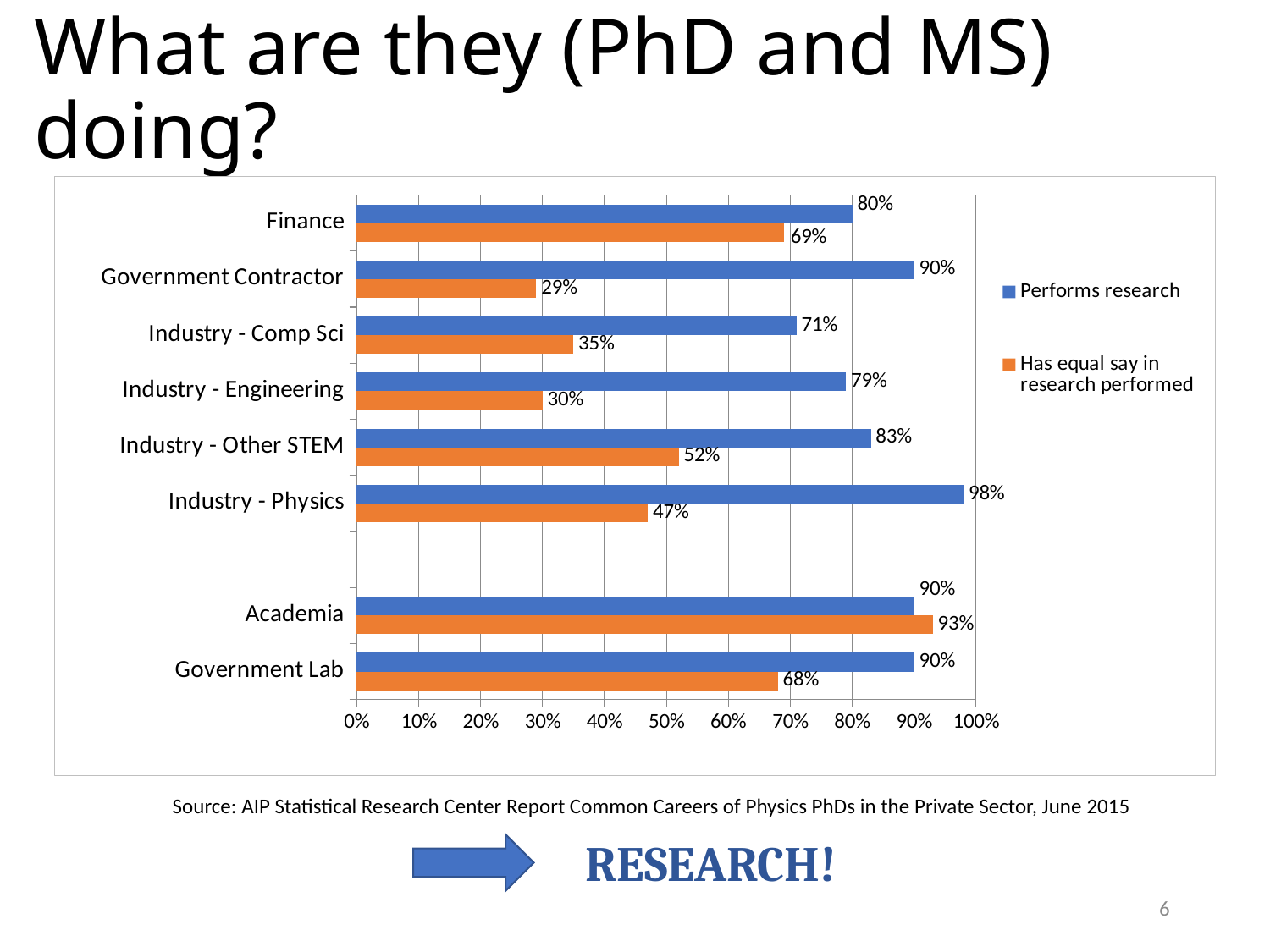
Which category has the lowest 'Performs research' value? Industry - Comp Sci What is the 'Performs research' value for Finance? 80% What percentage of Industry - Physics respondents perform research? 98% What kind of chart is shown on the slide? Bar chart Which colour represents the 'Performs research' series? Blue Which category has the highest 'Performs research' value? Industry - Physics How many series does the legend list? 2 Is the 'Has equal say in research performed' value for Industry - Engineering greater or less than 40%? less What is the 'Has equal say in research performed' value for Government Contractor? 29% What is the difference between the 'Performs research' and 'Has equal say in research performed' values for Government Contractor? 61 percentage points For Academia, which is larger: 'Performs research' or 'Has equal say in research performed'? Has equal say in research performed Which category has the lowest 'Has equal say in research performed' value? Government Contractor